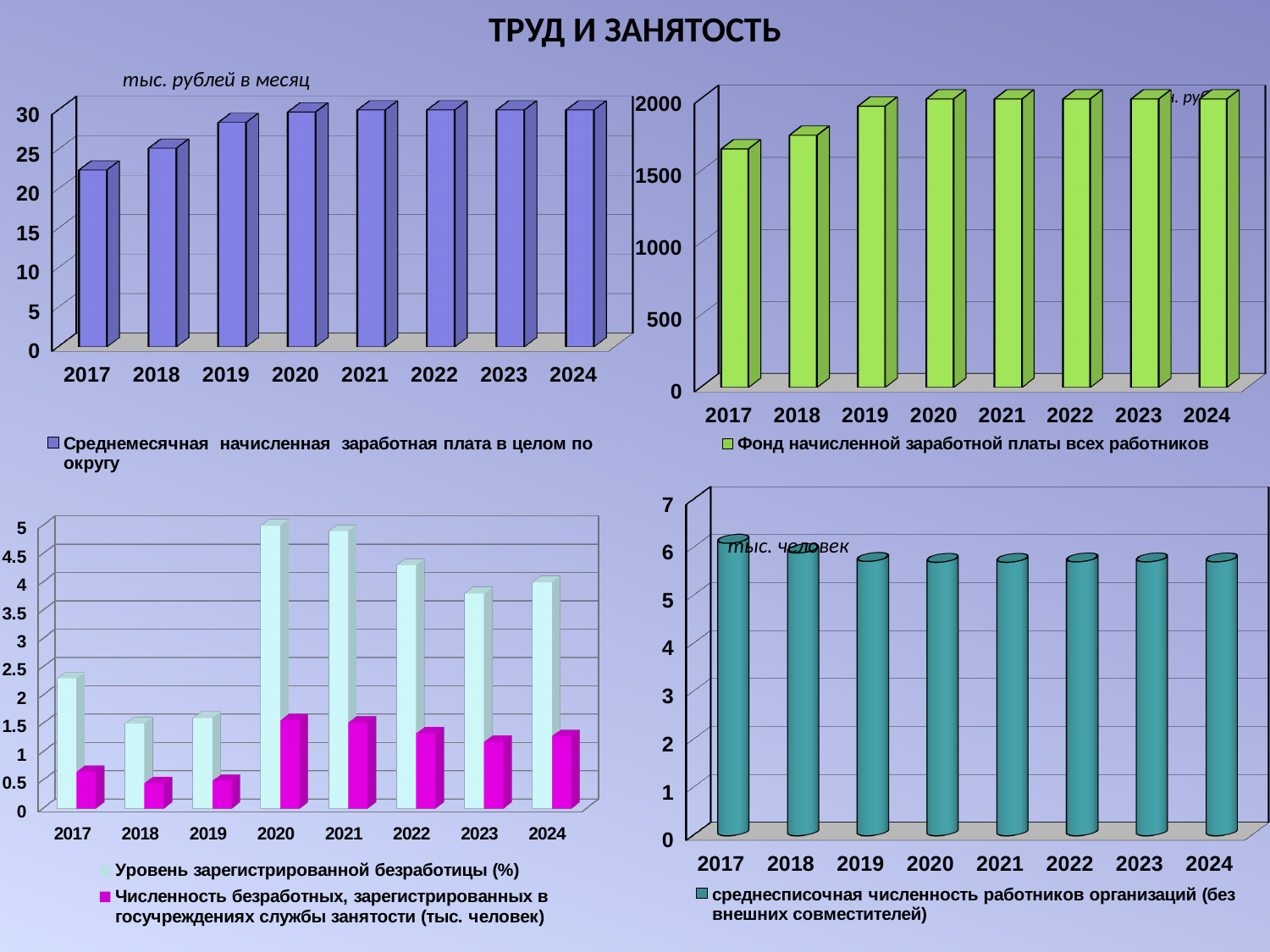
In the top-right chart (Фонд начисленной заработной платы всех работников), which year has the lowest value? 2017 In the bottom-right chart (среднесписочная численность работников организаций), is the value for 2019 greater or less than 6? less In the top-right chart (Фонд начисленной заработной платы всех работников), is the value for 2017 greater or less than 1500? greater In the top-left chart (Среднемесячная начисленная заработная плата), which year has the lowest value? 2017 In the top-right chart (Фонд начисленной заработной платы всех работников), do the values rise or fall from 2017 to 2019? rise What colour are the bars in the bottom-right chart (среднесписочная численность работников организаций)? teal How many series does the legend of the bottom-left chart (Уровень зарегистрированной безработицы) list? 2 What kind of chart is the top-left chart (Среднемесячная начисленная заработная плата в целом по округу)? bar chart In the top-left chart (Среднемесячная начисленная заработная плата), how many years are shown on the x axis? 8 In the bottom-left chart, which is larger: Уровень зарегистрированной безработицы (%) for 2020 or for 2017? 2020 In the bottom-left chart, is the value of Уровень зарегистрированной безработицы (%) for 2020 greater or less than 4? greater